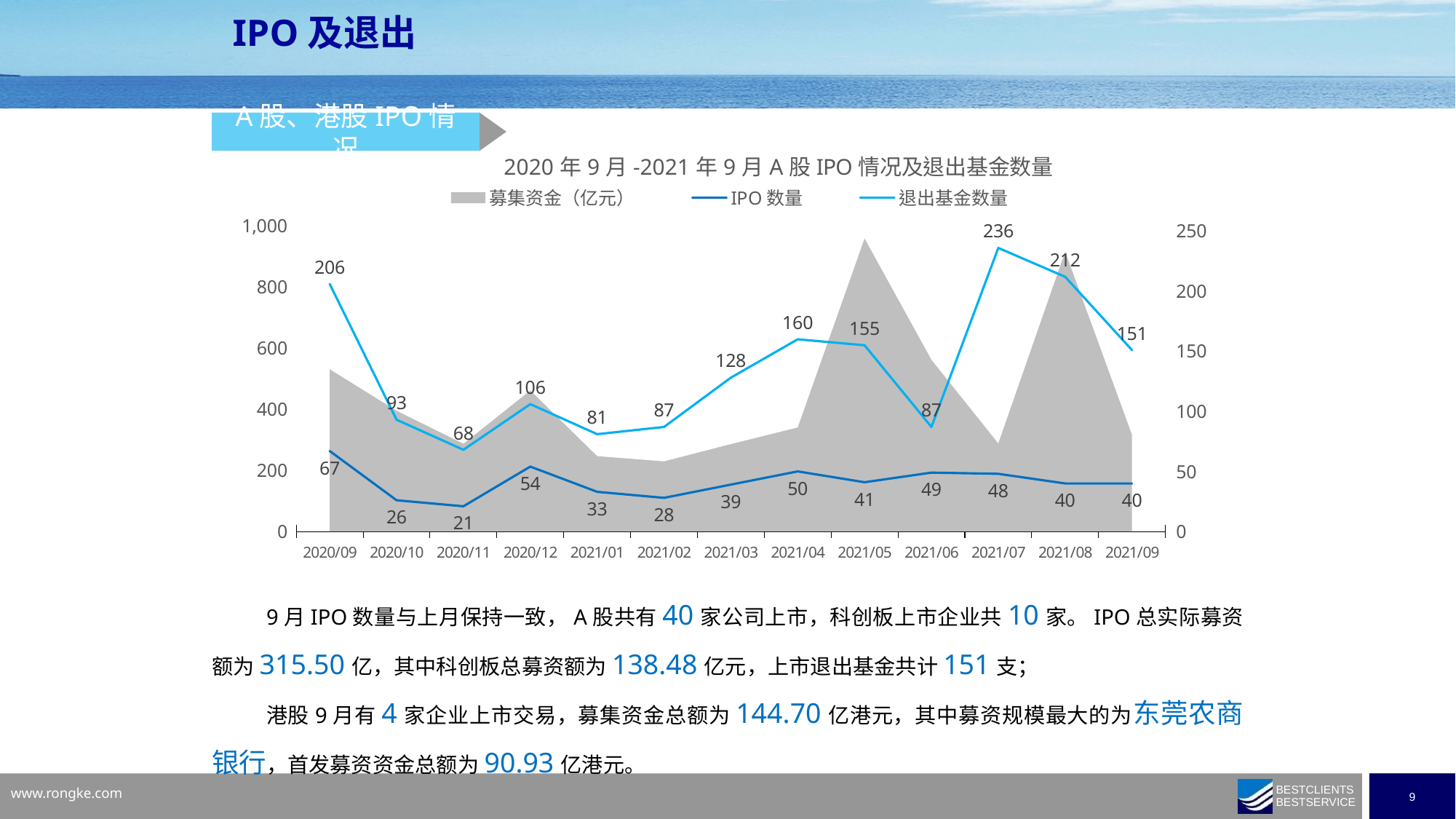
How many months are shown on the x axis? 13 What is the IPO数量 value for 2020/09? 67 What is the difference between the 退出基金数量 values for 2021/07 and 2021/06? 149 Which month has the lowest IPO数量? 2020/11 What is the title of the chart? 2020年9月-2021年9月A股IPO情况及退出基金数量 Which is larger, the IPO数量 for 2020/12 or for 2021/04? 2020/12 Is the 募集资金（亿元） value for 2021/02 greater or less than 400? less What is the 退出基金数量 value for 2021/07? 236 How many series does the legend list? 3 Is the 募集资金（亿元） value for 2021/05 greater or less than 800? greater What is the 退出基金数量 value for 2021/09? 151 Which month has the highest 退出基金数量? 2021/07